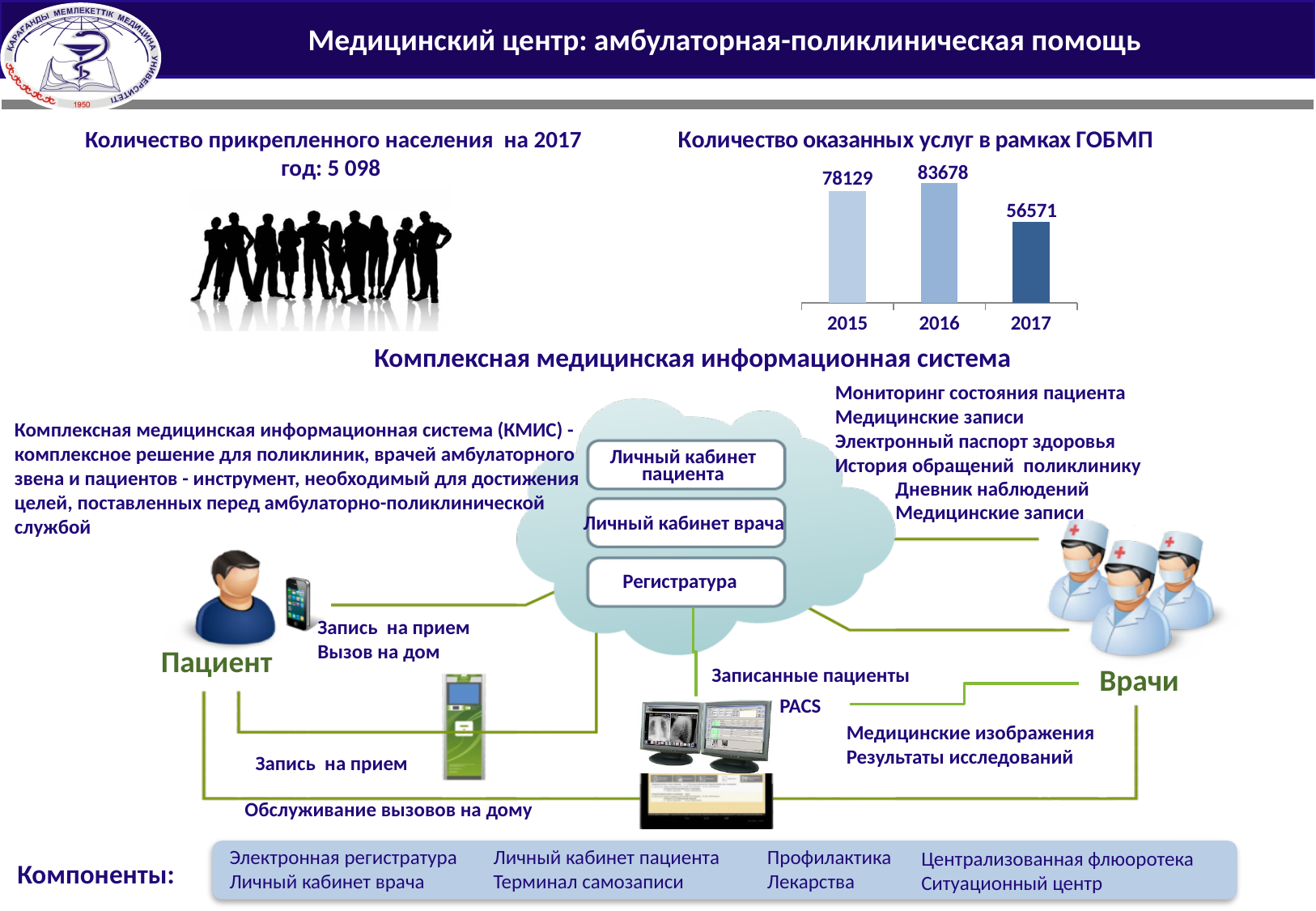
What kind of chart is 'Количество оказанных услуг в рамках ГОБМП'? bar chart What is the value for 2017 in the chart 'Количество оказанных услуг в рамках ГОБМП'? 56571 Which year has the lowest value in the chart 'Количество оказанных услуг в рамках ГОБМП'? 2017 What is the value for 2016 in the chart 'Количество оказанных услуг в рамках ГОБМП'? 83678 In the chart 'Количество оказанных услуг в рамках ГОБМП', does the value rise or fall from 2016 to 2017? fall How many years are shown in the chart 'Количество оказанных услуг в рамках ГОБМП'? 3 In the chart 'Количество оказанных услуг в рамках ГОБМП', which is larger, the value for 2015 or the value for 2017? 2015 Which year has the highest value in the chart 'Количество оказанных услуг в рамках ГОБМП'? 2016 What is the difference between the 2016 and 2017 values in the chart 'Количество оказанных услуг в рамках ГОБМП'? 27107 What is the title of the bar chart on the slide? Количество оказанных услуг в рамках ГОБМП What is the value for 2015 in the chart 'Количество оказанных услуг в рамках ГОБМП'? 78129 What is the difference between the 2016 and 2015 values in the chart 'Количество оказанных услуг в рамках ГОБМП'? 5549